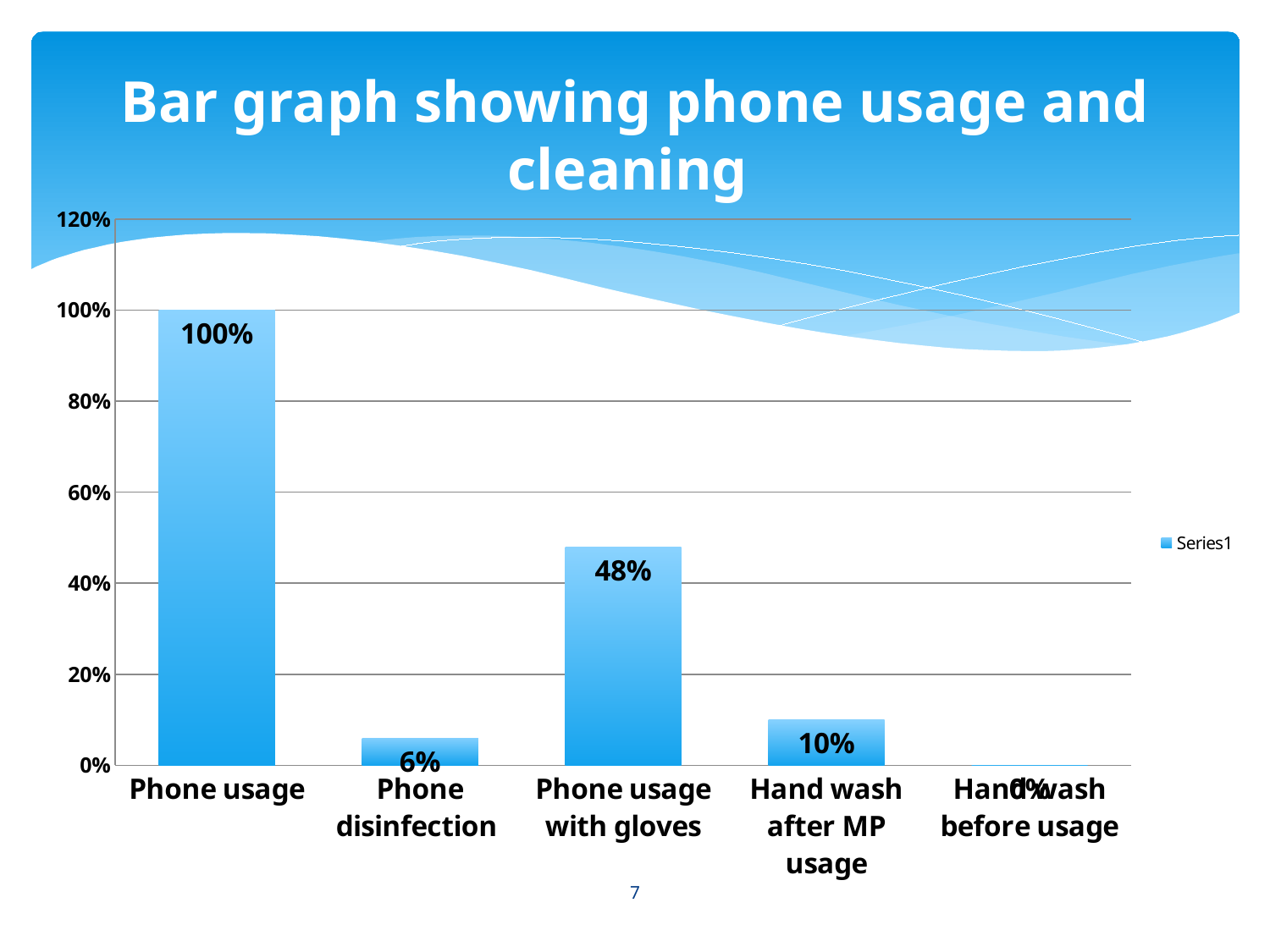
What is the title of the chart? Bar graph showing phone usage and cleaning Which category has the highest value? Phone usage What is the value for Phone usage? 100% How many categories are shown on the x axis? 5 What is the difference between the values for Phone usage and Phone usage with gloves? 52% Which is larger, the value for Phone disinfection or the value for Hand wash after MP usage? Hand wash after MP usage Is the value for Phone usage with gloves greater or less than 40%? greater What is the value for Phone usage with gloves? 48% What is the value for Hand wash after MP usage? 10% What kind of chart is shown on the slide? bar chart What is the value for Phone disinfection? 6% Which category has the lowest value? Hand wash before usage